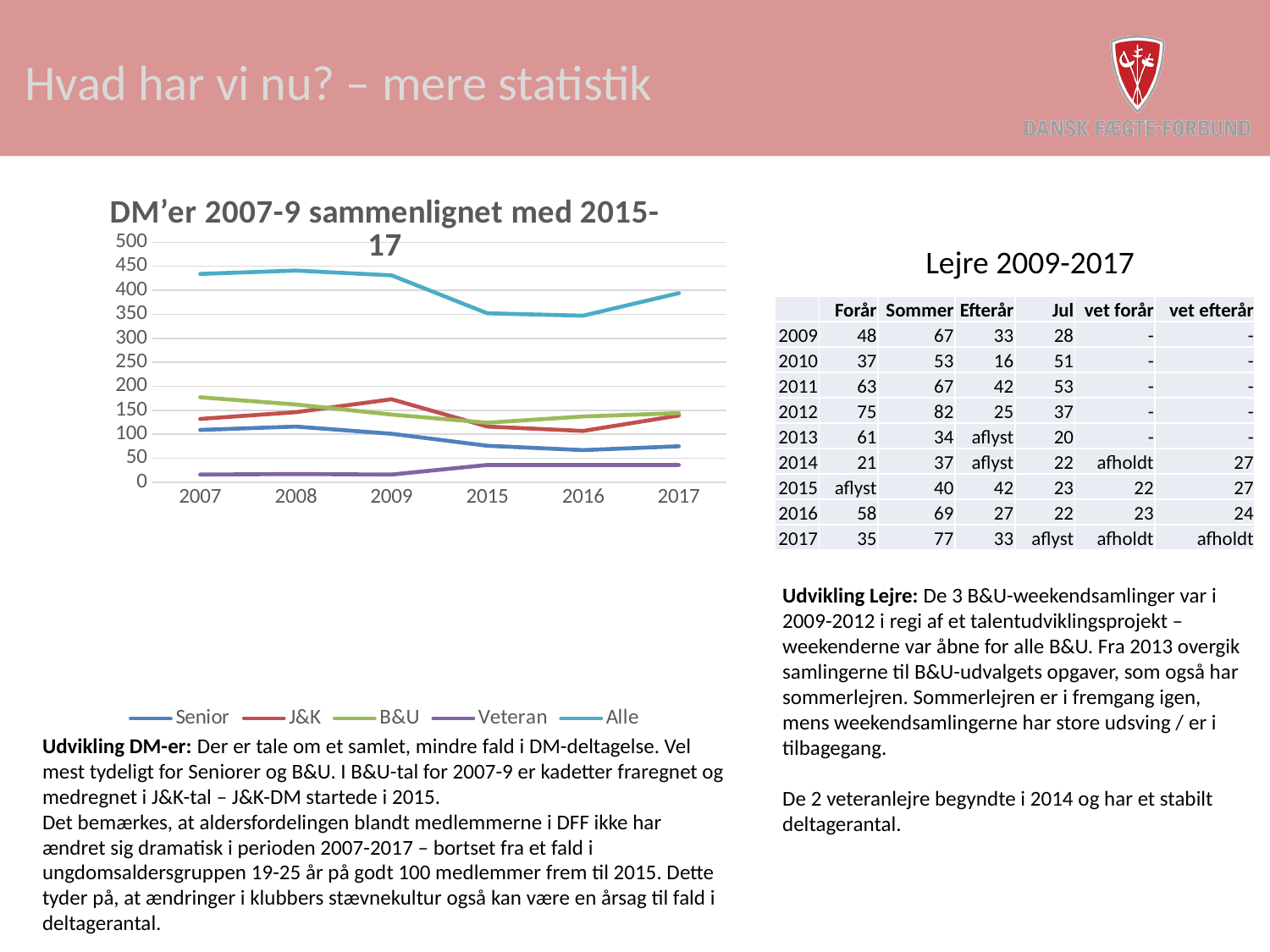
What is the title of the chart? DM'er 2007-9 sammenlignet med 2015-17 Is the value for Alle in 2007 greater or less than 400? greater Is the value for B&U in 2007 greater or less than 150? greater Is the value for Senior in 2016 greater or less than 100? less How many series does the legend of the chart list? 5 How many years are shown on the x axis of the chart? 6 Does the Senior series rise or fall from 2007 to 2016? fall Which series has the highest values across all years in the chart? Alle In 2009, which series has the larger value, J&K or B&U? J&K Which series has the lowest values across all years in the chart? Veteran What kind of chart is shown on the slide? line chart